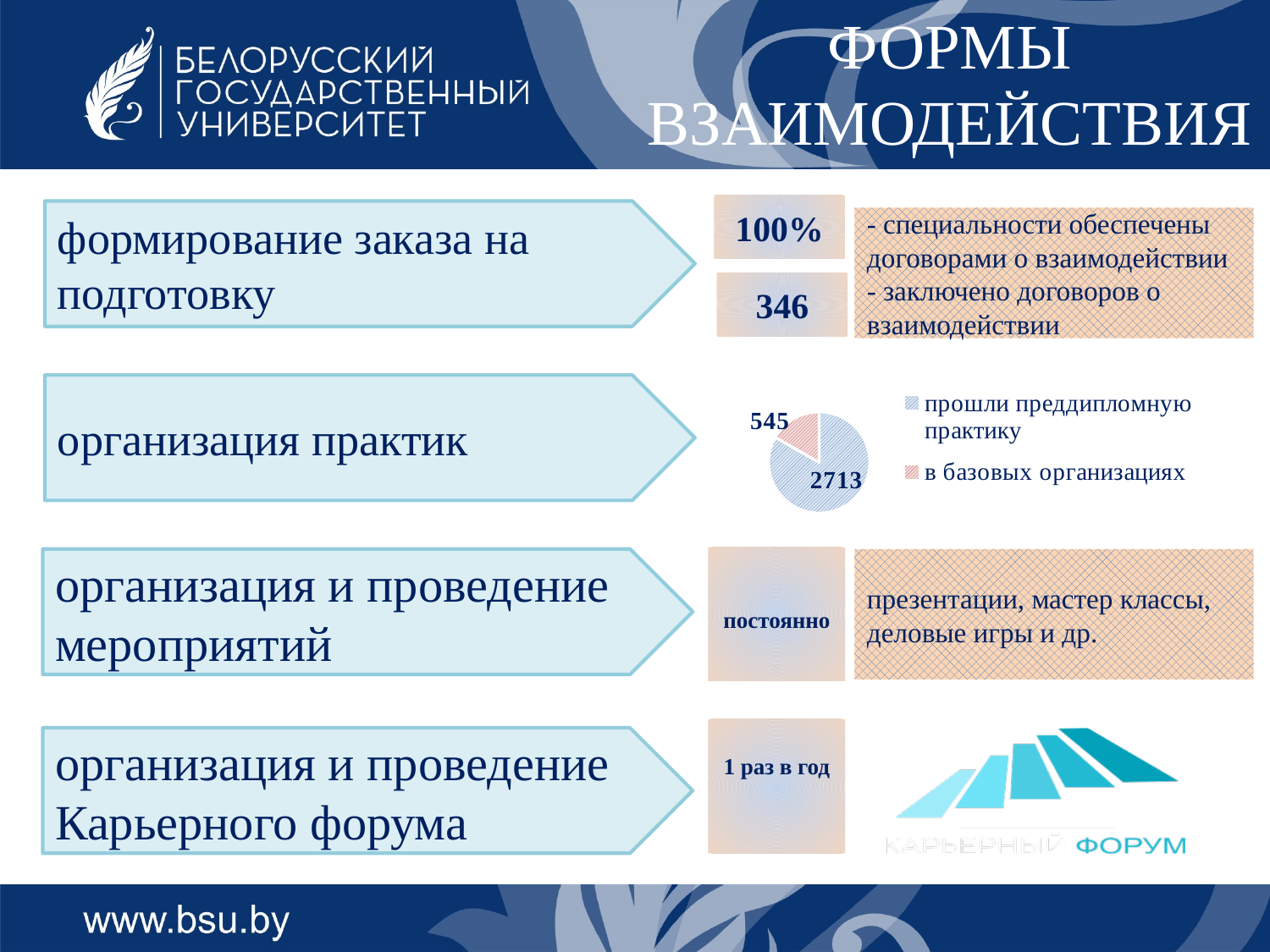
Which legend entry in the pie chart is shown in red/pink? в базовых организациях What is the value of the "в базовых организациях" slice in the pie chart? 545 Which is larger in the pie chart: "прошли преддипломную практику" or "в базовых организациях"? прошли преддипломную практику How many entries does the pie chart's legend list? 2 Which slice of the pie chart is the largest? прошли преддипломную практику Which slice of the pie chart is the smallest? в базовых организациях What is the value of the "прошли преддипломную практику" slice in the pie chart? 2713 What kind of chart is shown next to "организация практик"? pie chart What is the total of the two values shown in the pie chart? 3258 What is the difference between the two values shown in the pie chart? 2168 How many slices does the pie chart have? 2